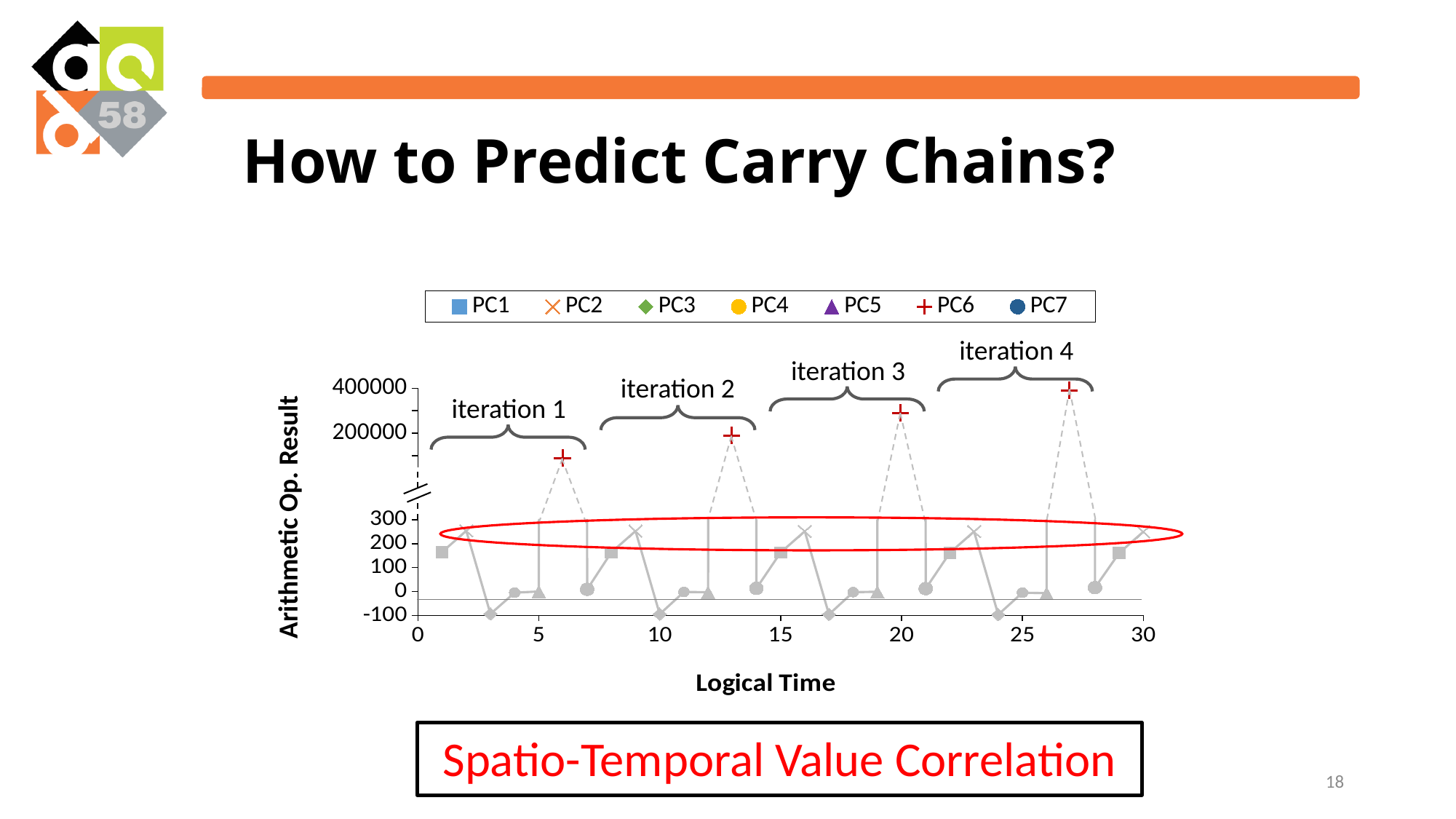
What is the title of the x axis? Logical Time Is the value for PC6 in iteration 1 (at logical time 6) greater or less than 200000? less How many series does the legend list? 7 What kind of chart is shown on the slide? line chart Do the PC6 values rise or fall as logical time increases? rise Is the value for PC6 in iteration 4 (at logical time 27) greater or less than 200000? greater Which series reaches the highest values on the chart? PC6 Which series has the lowest values on the chart? PC3 Which is larger at the start of iteration 1: the value for PC1 or the value for PC2? PC2 Is the value for PC1 at logical time 1 greater or less than 100? greater What is the title of the y axis? Arithmetic Op. Result